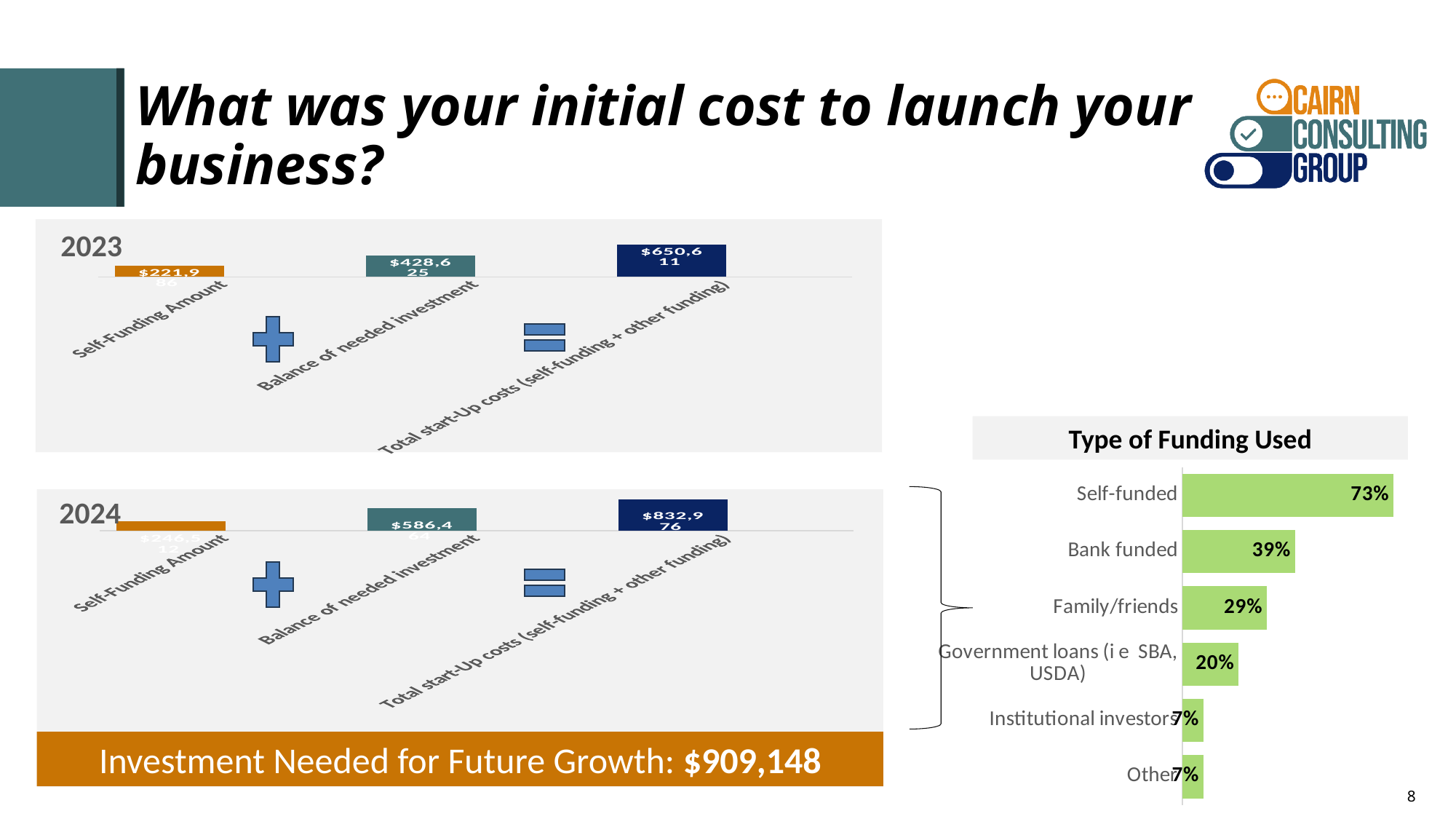
In the Type of Funding Used chart, what percentage is shown for Government loans (i e SBA, USDA)? 20% In the 2024 chart, what is the value for Balance of needed investment? $586,464 In the 2023 chart, what is the value for Balance of needed investment? $428,625 In the Type of Funding Used chart, what is the difference between the Self-funded and Bank funded percentages? 34% In the 2023 chart, what is the value for Total start-Up costs (self-funding + other funding)? $650,611 How many funding types are listed in the Type of Funding Used chart? 6 In the Type of Funding Used chart, which is larger, Family/friends or Government loans (i e SBA, USDA)? Family/friends In the 2024 chart, what is the value for Total start-Up costs (self-funding + other funding)? $832,976 In the Type of Funding Used chart, which funding type has the highest percentage? Self-funded In the Type of Funding Used chart, what percentage is shown for Self-funded? 73% What kind of chart is the Type of Funding Used chart? Bar chart In the Type of Funding Used chart, what percentage is shown for Bank funded? 39%